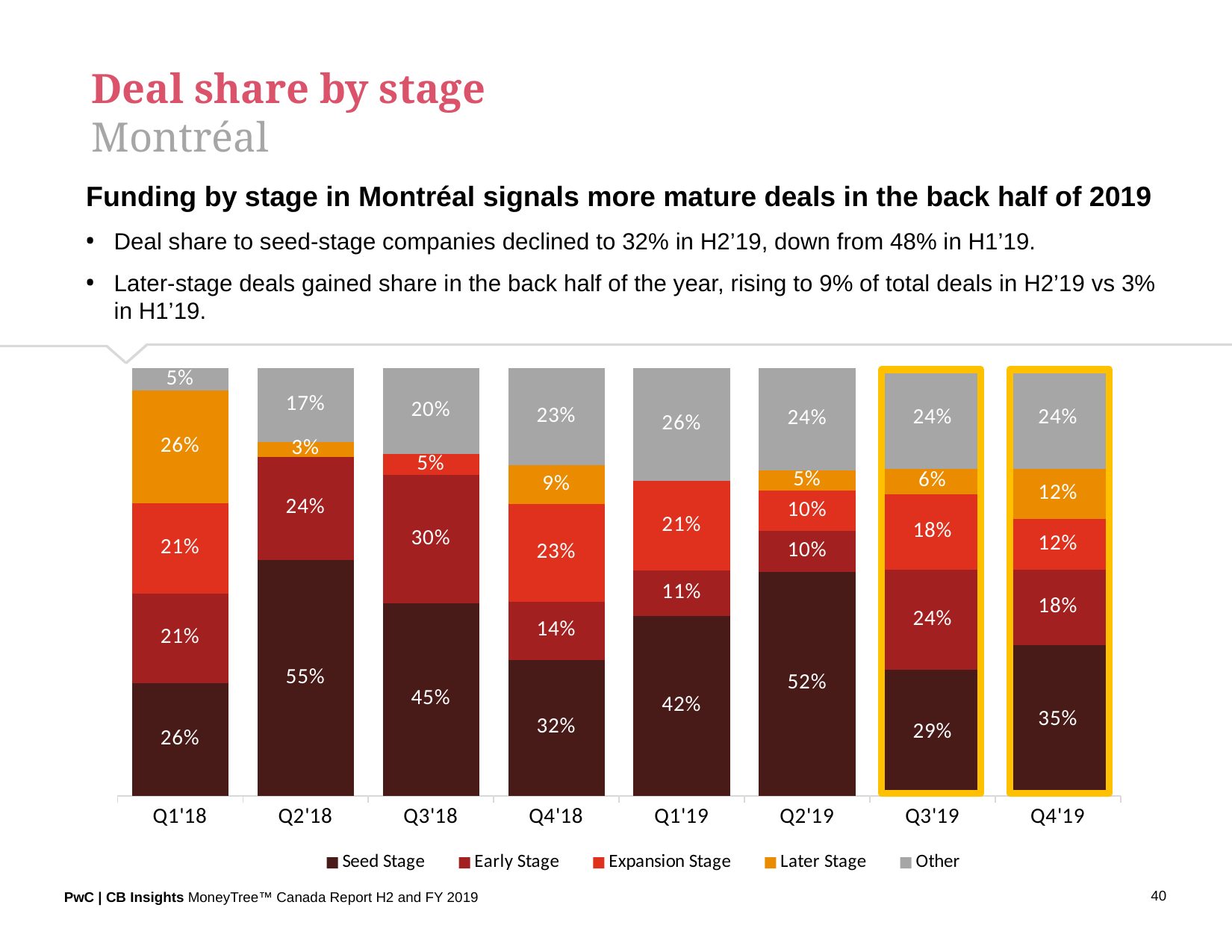
What is the difference between the Seed Stage share in Q2'19 and Q3'19? 23% What is the Other share for Q1'18? 5% How many series does the legend list? 5 Which is larger, the Early Stage share in Q3'18 or in Q4'18? Q3'18 In which quarter is the Seed Stage share lowest? Q1'18 What is the Later Stage share for Q4'19? 12% Does the Other share rise or fall from Q1'18 to Q1'19? Rise How many quarters are shown on the x axis? 8 What is the Seed Stage share for Q2'18? 55% What is the Expansion Stage share for Q3'19? 18% What kind of chart is shown on the slide? Stacked bar chart In which quarter is the Seed Stage share highest? Q2'18